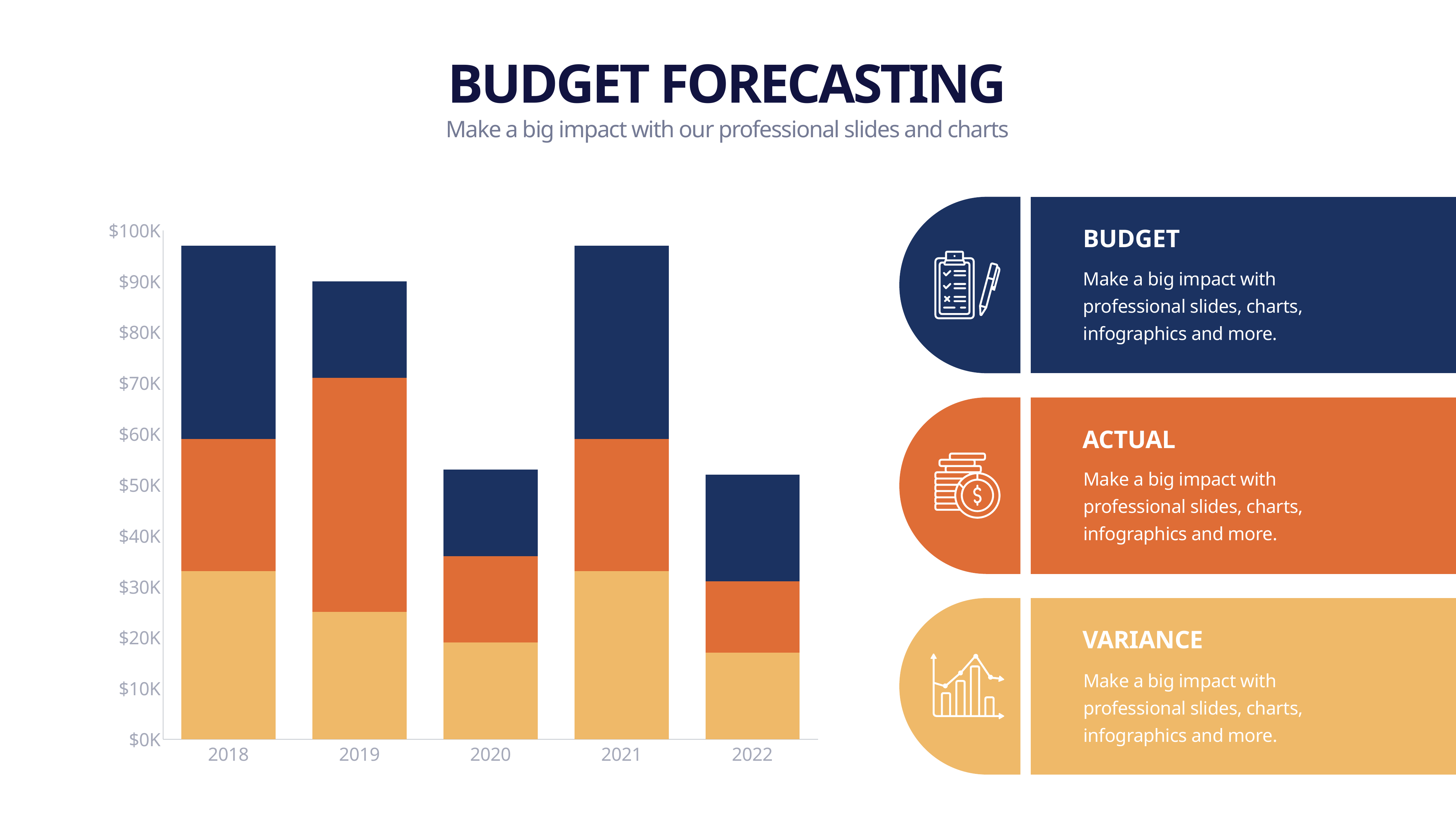
How many coloured segments make up each stacked bar? 3 How many years are shown on the x axis of the chart? 5 Is the total value of the bar for 2021 greater or less than $100K? less What is the title of the slide containing the chart? BUDGET FORECASTING Is the total value of the bar for 2019 greater or less than $80K? greater Which bar is taller, 2018 or 2020? 2018 What kind of chart is shown on the slide? Stacked bar chart Is the total value of the bar for 2022 greater or less than $50K? greater Which bar is taller, 2019 or 2022? 2019 Does the total bar value rise or fall from 2021 to 2022? fall